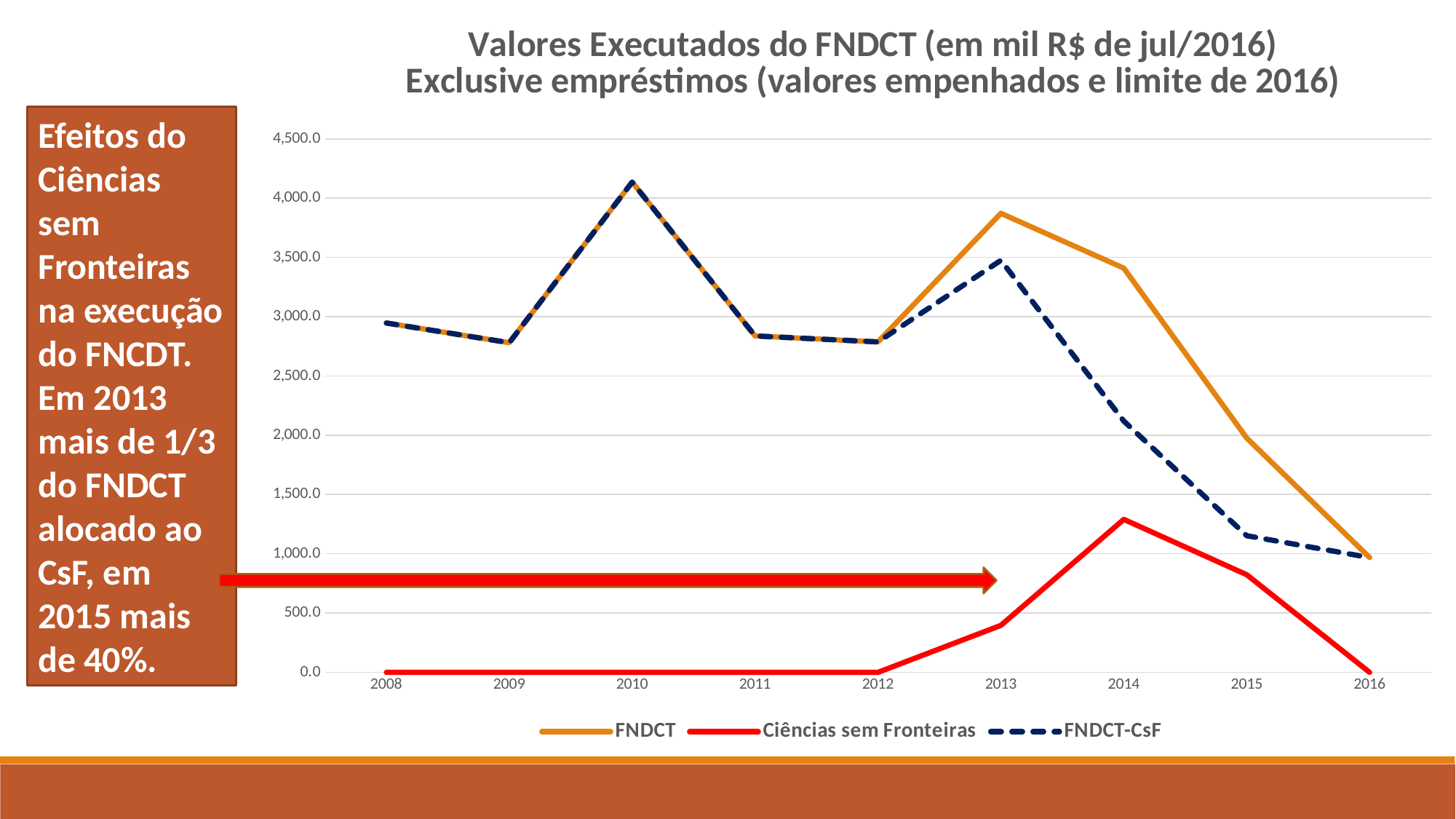
How many years are plotted along the x axis? 9 In which year does the FNDCT series reach its highest value? 2010 How many series does the legend list? 3 In 2013, which series has the larger value, FNDCT or FNDCT-CsF? FNDCT Is the FNDCT-CsF value for 2015 greater or less than 1,500.0? less Does the FNDCT series rise or fall from 2013 to 2016? fall Is the Ciências sem Fronteiras value for 2014 greater or less than 1,000.0? greater What type of chart is shown on the slide? line chart In which year does the Ciências sem Fronteiras series reach its highest value? 2014 Is the FNDCT value for 2010 greater or less than 4,000.0? greater In which year is the FNDCT series at its lowest value? 2016 Which series is drawn with a dashed line in the legend? FNDCT-CsF